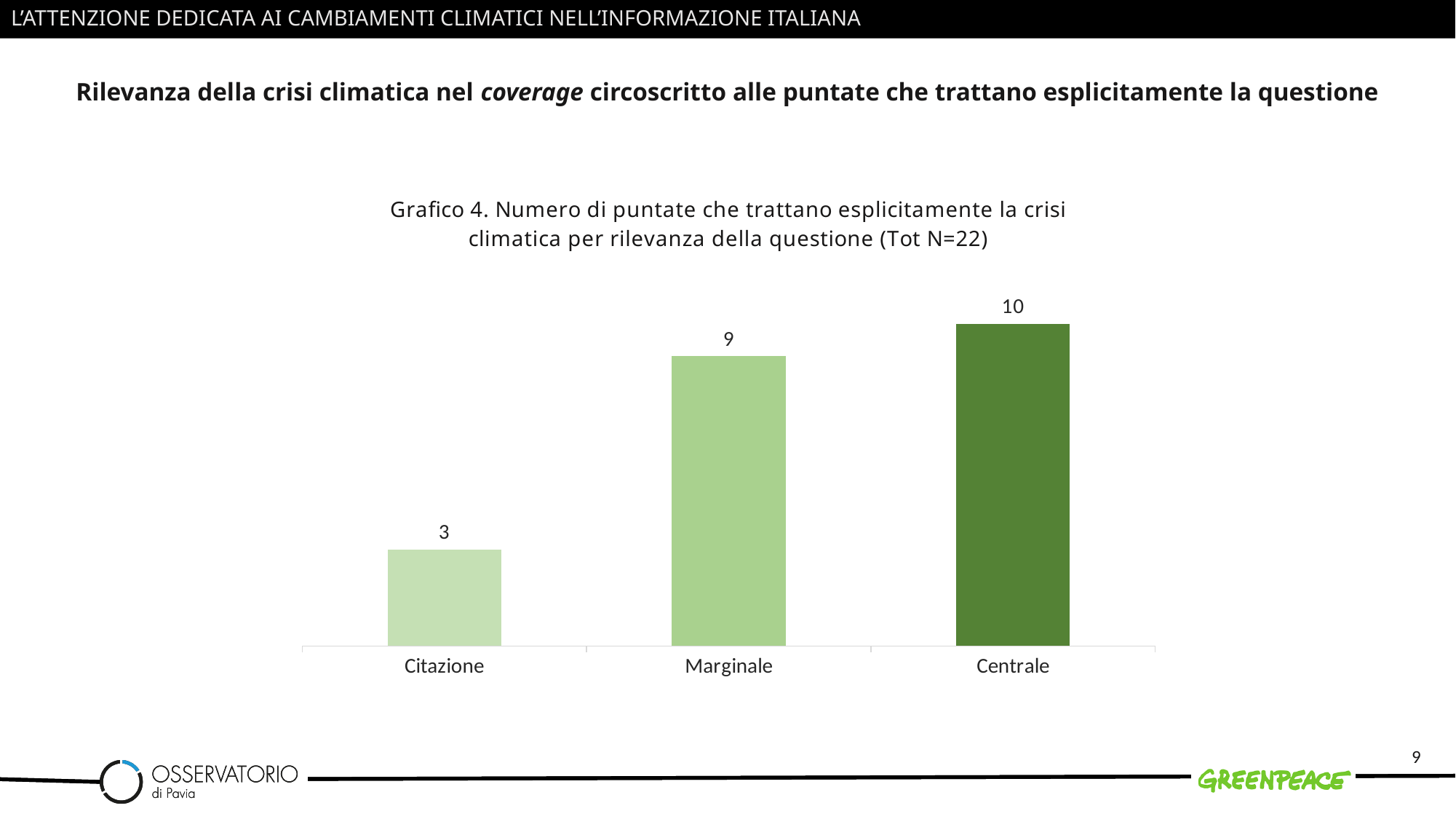
Do the values rise or fall from Citazione to Centrale along the x axis? Rise What is the difference between the values for Centrale and Citazione? 7 How many categories are shown on the x axis? 3 Which category has the highest value? Centrale What total N is stated in the chart title? 22 Which is larger, the value for Marginale or the value for Citazione? Marginale What is the value for Marginale? 9 What kind of chart is shown on the slide? Bar chart Which category has the lowest value? Citazione What is the difference between the values for Marginale and Citazione? 6 What is the value for Citazione? 3 What is the value for Centrale? 10